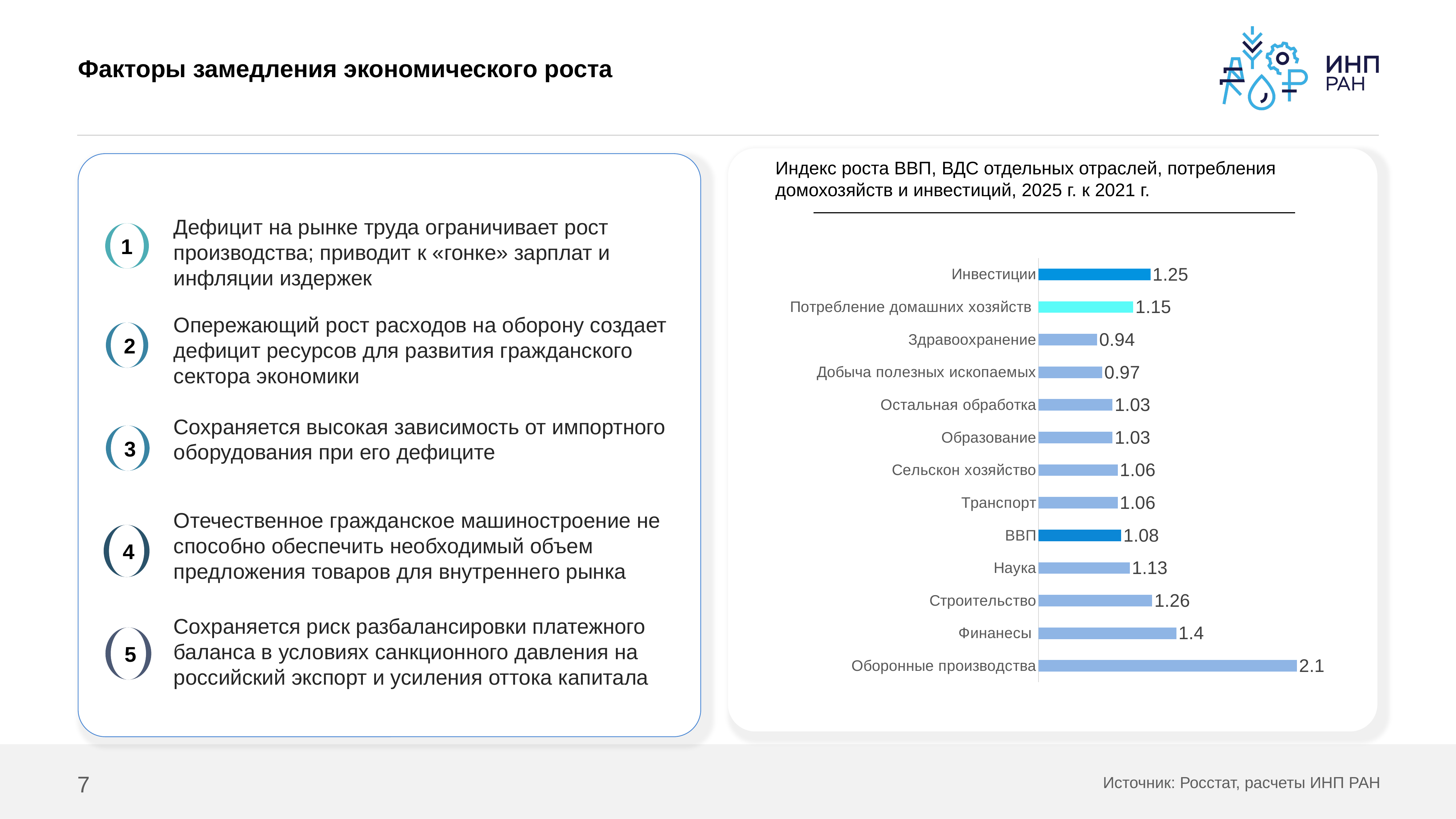
What is the value for Потребление домашних хозяйств? 1.15 How many categories are shown in the chart? 13 Which category has the lowest value? Здравоохранение Which category has the highest value? Оборонные производства What is the value for Финанесы? 1.4 What is the title of the chart? Индекс роста ВВП, ВДС отдельных отраслей, потребления домохозяйств и инвестиций, 2025 г. к 2021 г. What is the difference between the values for Оборонные производства and Финанесы? 0.7 What is the value for Инвестиции? 1.25 What is the difference between the values for Инвестиции and ВВП? 0.17 What kind of chart is shown on the slide? Bar chart What is the value for ВВП? 1.08 Which is larger, the value for Финанесы or the value for Наука? Финанесы